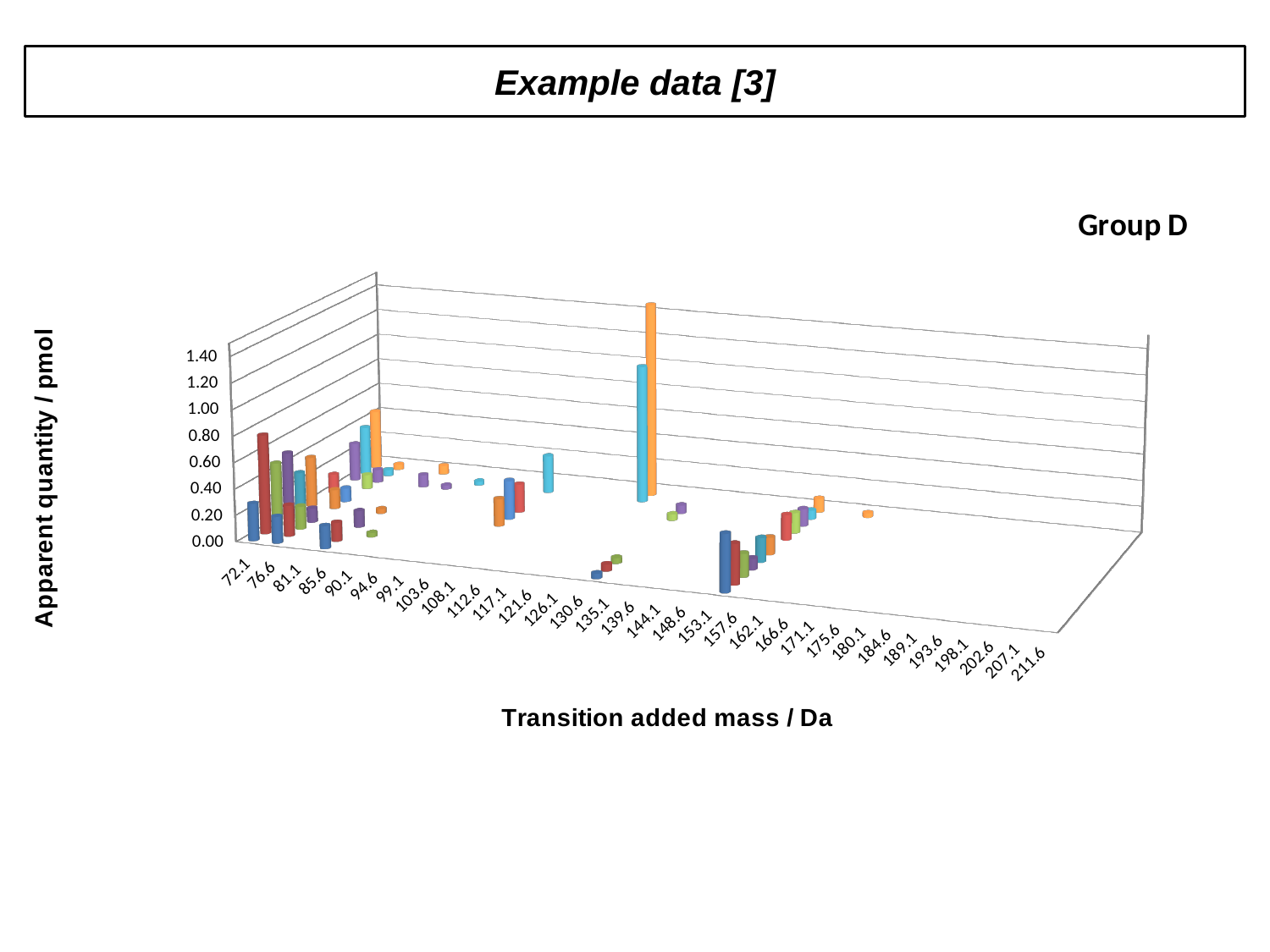
What kind of chart is shown on the slide? bar chart What is the label of the x axis of the chart? Transition added mass / Da What is the title of the chart? Group D What is the highest tick value shown on the vertical axis? 1.40 What is the lowest tick value shown on the vertical axis? 0.00 What is the first category labelled on the x axis? 72.1 What is the interval between consecutive ticks on the vertical axis? 0.20 What is the last category labelled on the x axis? 211.6 How many categories are labelled along the x axis of the chart? 32